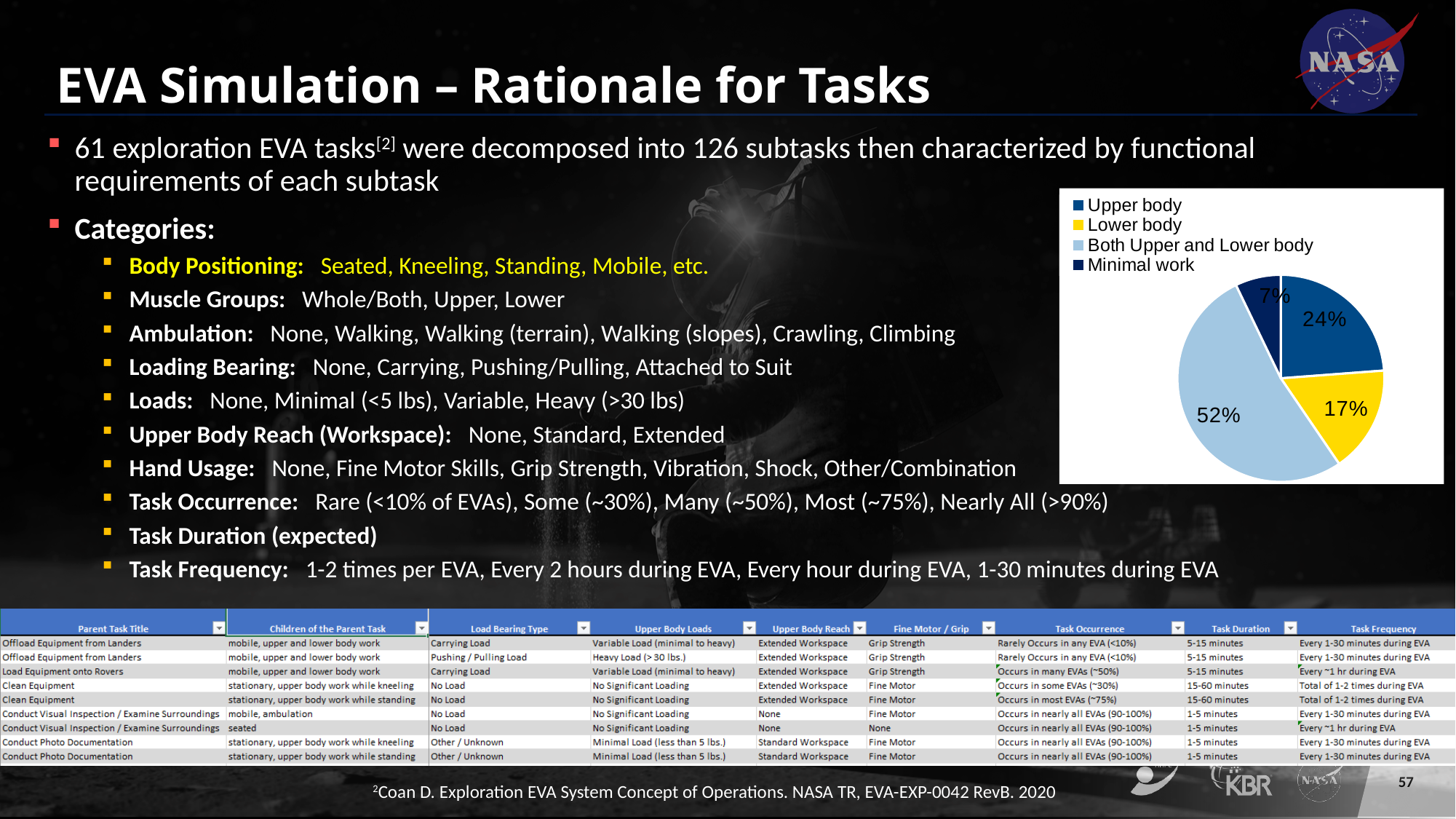
What share of the pie chart is labelled Minimal work? 7% Which slice is larger in the pie chart, Upper body or Lower body? Upper body What kind of chart is shown on the slide? pie chart What share of the pie chart is labelled Lower body? 17% What is the difference in percentage points between the Both Upper and Lower body slice and the Upper body slice? 28 What share of the pie chart is labelled Upper body? 24% What is the difference in percentage points between the Lower body slice and the Minimal work slice? 10 How many categories does the pie chart legend list? 4 What colour is the Lower body slice in the pie chart? yellow Which category has the largest slice in the pie chart? Both Upper and Lower body Which category has the smallest slice in the pie chart? Minimal work